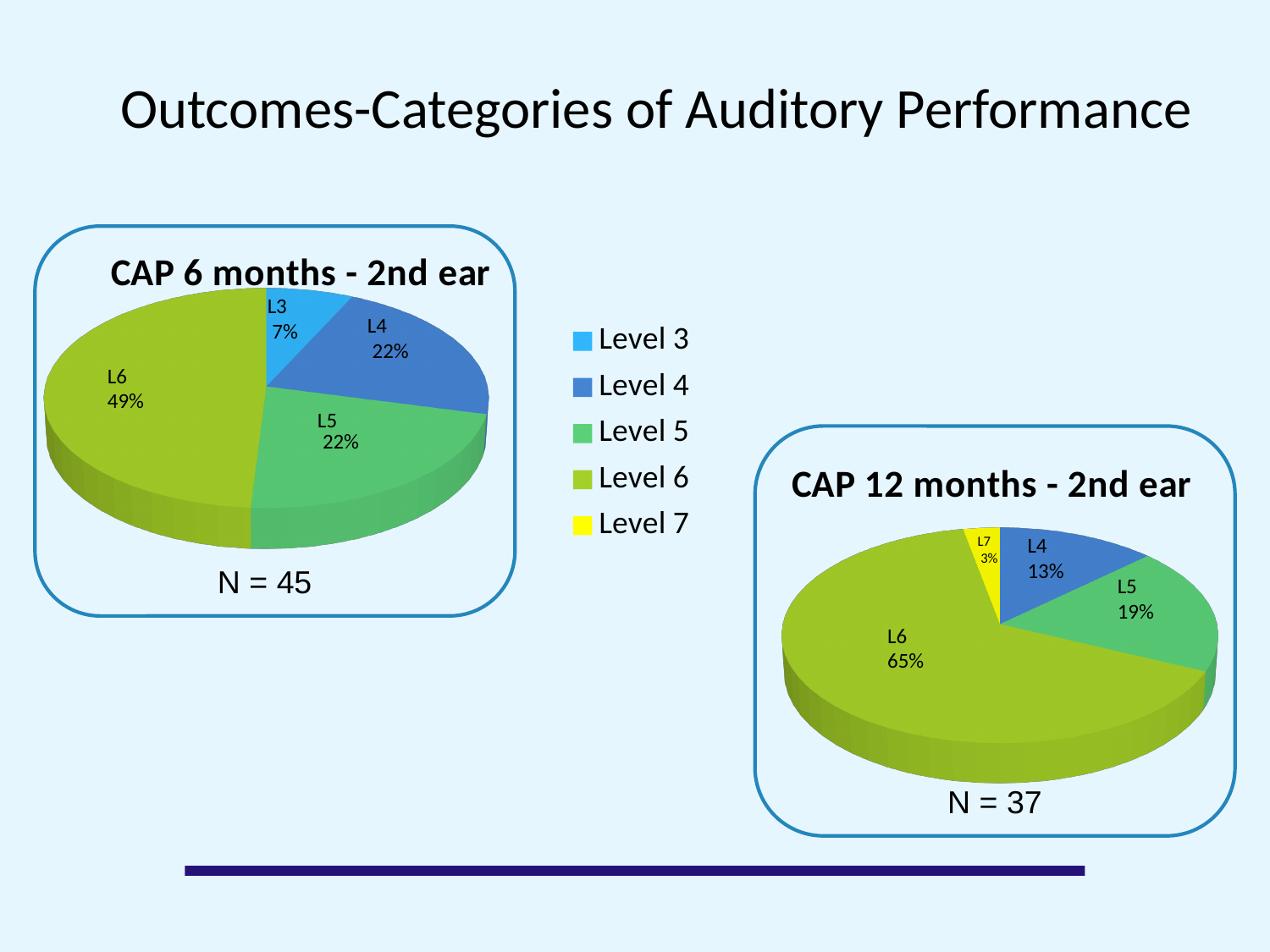
In the 'CAP 12 months - 2nd ear' chart, which level has the smallest share? L7 What type of chart is 'CAP 12 months - 2nd ear'? Pie chart In the 'CAP 6 months - 2nd ear' chart, what percentage is shown for L6? 49% In the 'CAP 12 months - 2nd ear' chart, which is larger: the share for L4 or the share for L5? L5 In the 'CAP 6 months - 2nd ear' chart, which level has the smallest share? L3 How many slices does the 'CAP 6 months - 2nd ear' pie chart have? 4 In the 'CAP 6 months - 2nd ear' chart, which level has the largest share? L6 In the 'CAP 12 months - 2nd ear' chart, what percentage is shown for L7? 3% What is the N value shown under the 'CAP 12 months - 2nd ear' chart? N = 37 What is the difference between the L6 share in the 'CAP 12 months - 2nd ear' chart and the L6 share in the 'CAP 6 months - 2nd ear' chart? 16% How many entries does the legend list? 5 In the 'CAP 12 months - 2nd ear' chart, what percentage is shown for L5? 19%